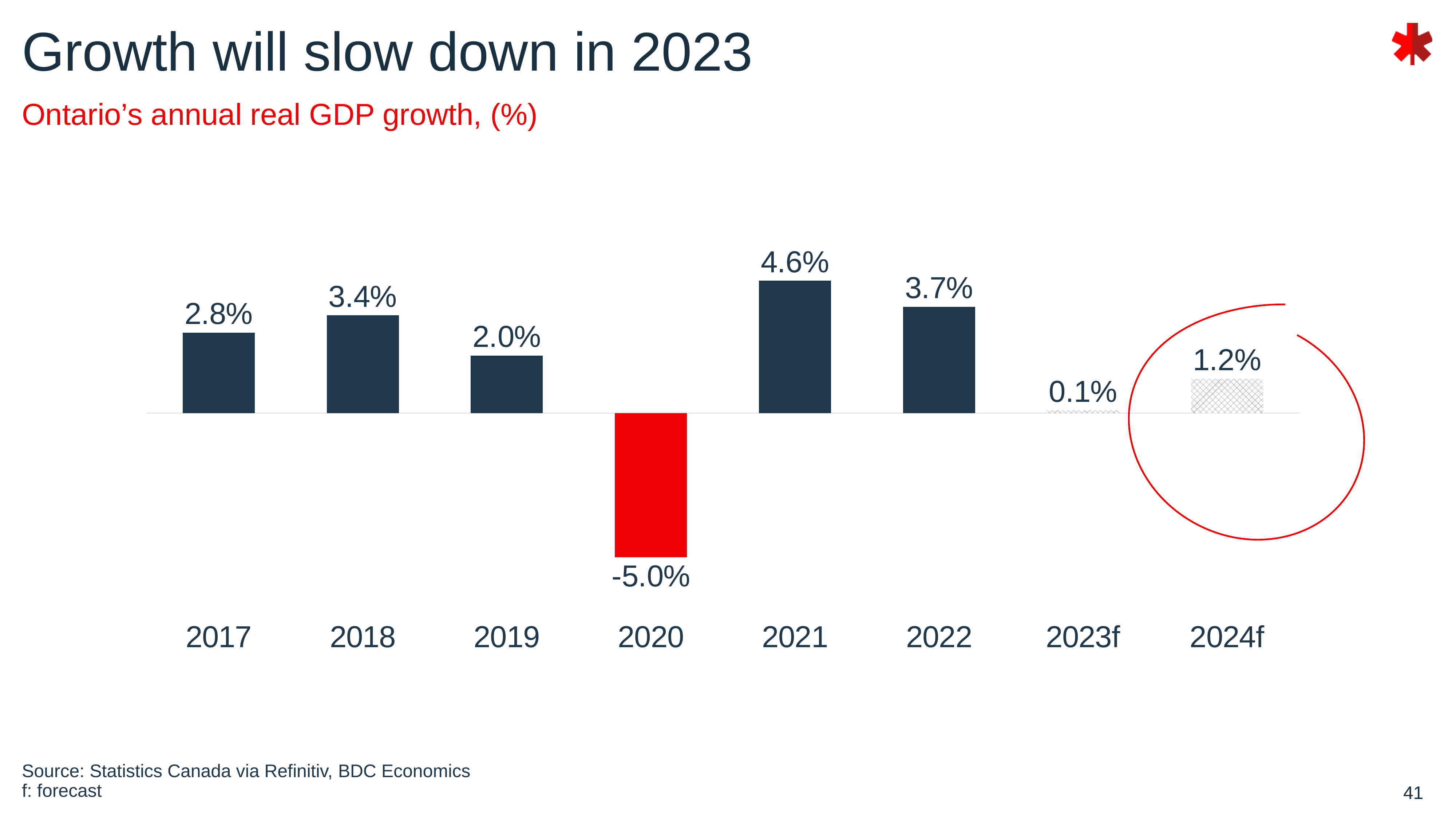
Which year has the lowest real GDP growth? 2020 What is the difference between the 2021 and 2022 values? 0.9% What is Ontario's real GDP growth for 2021? 4.6% What is the difference between the 2018 and 2019 values? 1.4% What is the forecast value for 2024f? 1.2% How many years are shown on the x axis? 8 What is the forecast real GDP growth for 2023f? 0.1% What kind of chart is shown on the slide? bar chart What is the value shown for 2020? -5.0% Which is larger, the value for 2017 or the value for 2018? 2018 Which year has the highest real GDP growth? 2021 Which bar is coloured red? 2020